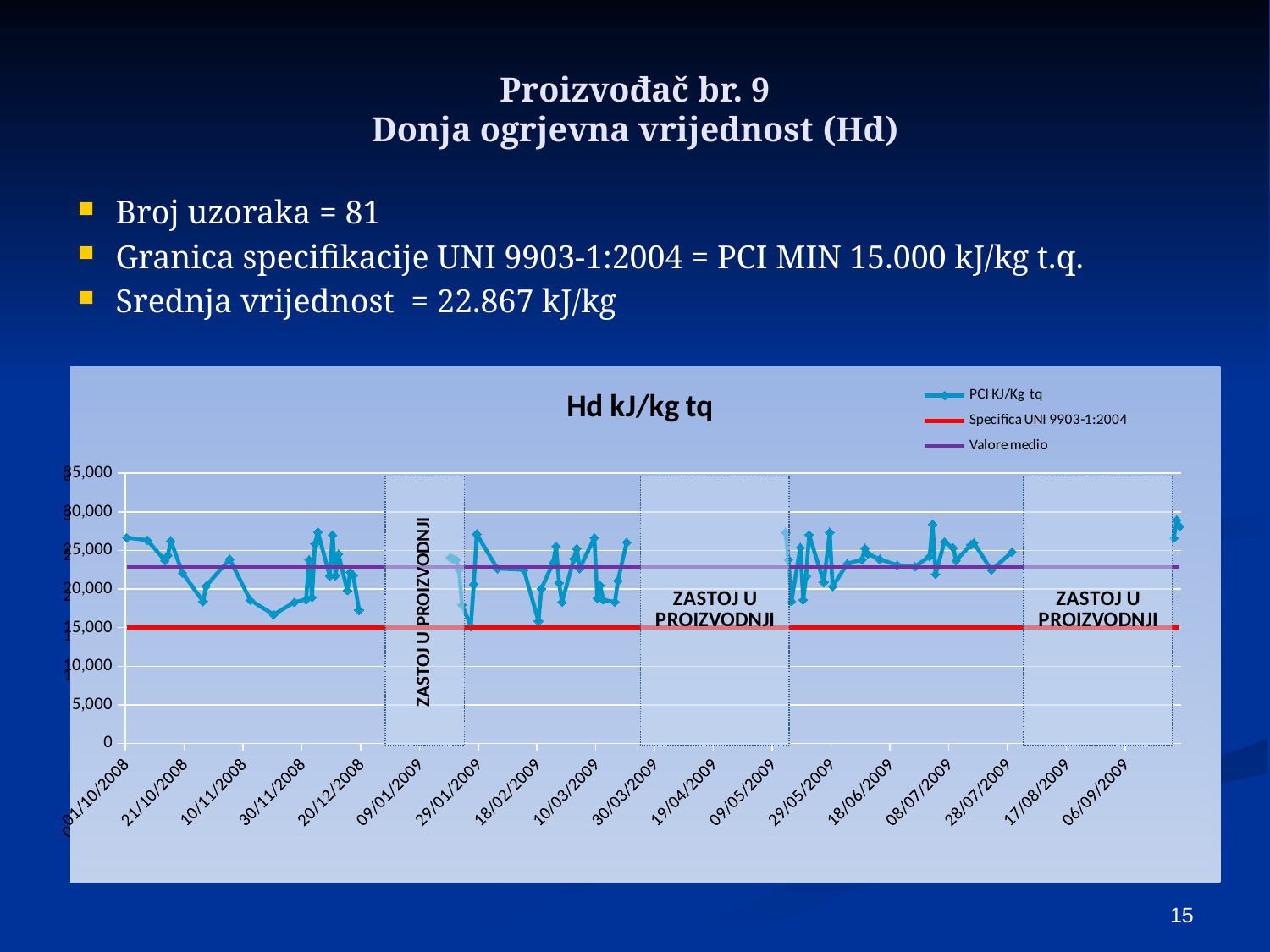
Which legend entry corresponds to the red line in the chart? Specifica UNI 9903-1:2004 At what value does the Specifica UNI 9903-1:2004 line sit on the y axis? 15,000 Is the Valore medio line greater or less than 25,000? less Is the Valore medio line greater or less than 20,000? greater What kind of chart is shown on the slide? line chart What is the highest value shown on the y axis of the chart? 35,000 Which series is higher, Valore medio or Specifica UNI 9903-1:2004? Valore medio Is the PCI KJ/Kg tq value around 30/11/2008 greater or less than 20,000? less What is the title of the chart? Hd kJ/kg tq How many series does the chart legend list? 3